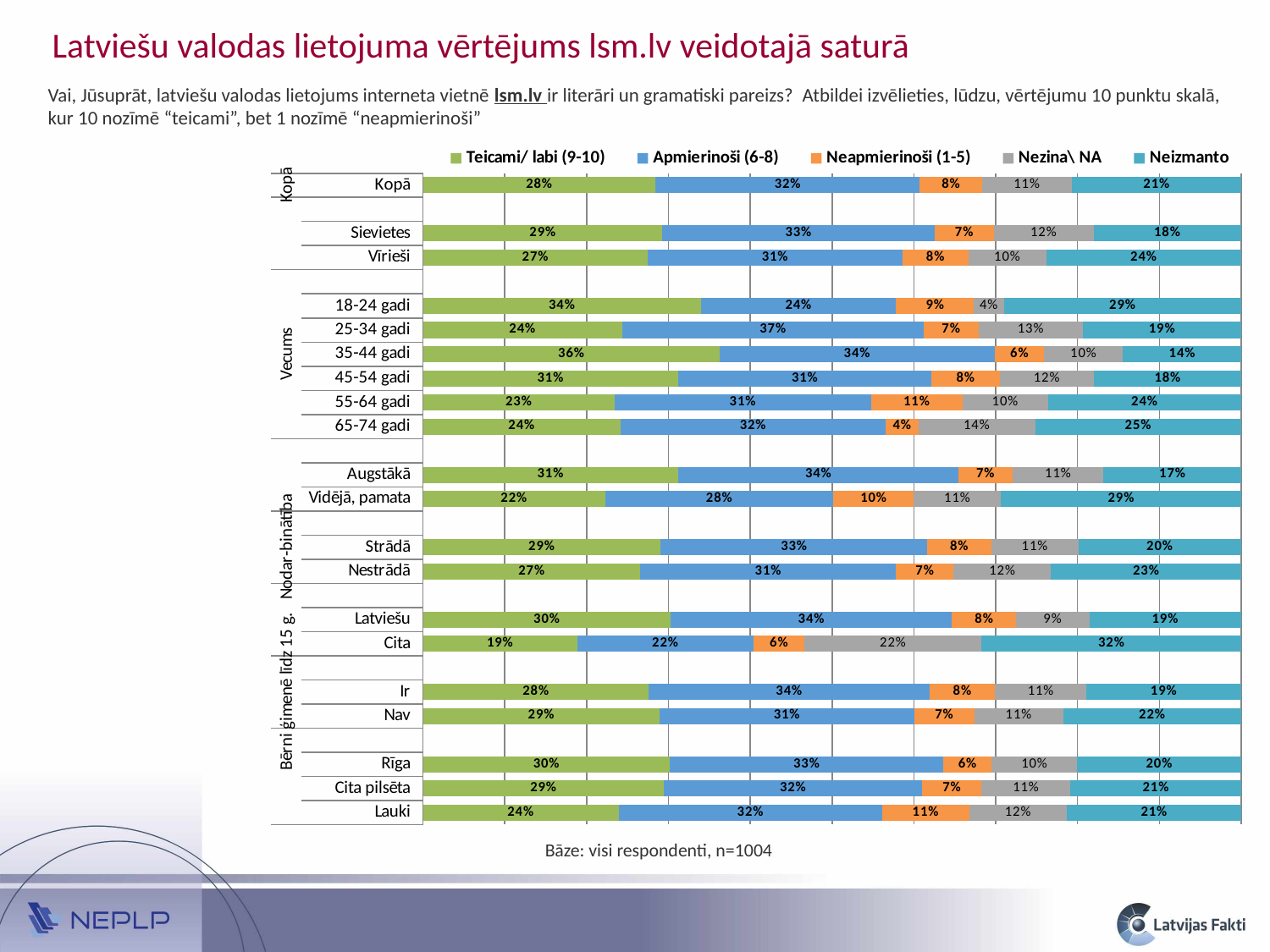
What is the Neapmierinoši (1-5) value for Lauki? 11% What is the difference between the Apmierinoši (6-8) values for 35-44 gadi and 18-24 gadi? 10% What is the Neizmanto value for Cita? 32% What type of chart is shown on the slide? stacked bar chart How many series does the legend list? 5 What is the Apmierinoši (6-8) value for 25-34 gadi? 37% What is the Teicami/ labi (9-10) value for Kopā? 28% Which category has the highest Teicami/ labi (9-10) value? 35-44 gadi Which is larger, the Teicami/ labi (9-10) value for Augstākā or for Vidējā, pamata? Augstākā Which category has the lowest Nezina\ NA value? 18-24 gadi Which category has the lowest Teicami/ labi (9-10) value? Cita What is the difference between the Neizmanto values for Vīrieši and Sievietes? 6%